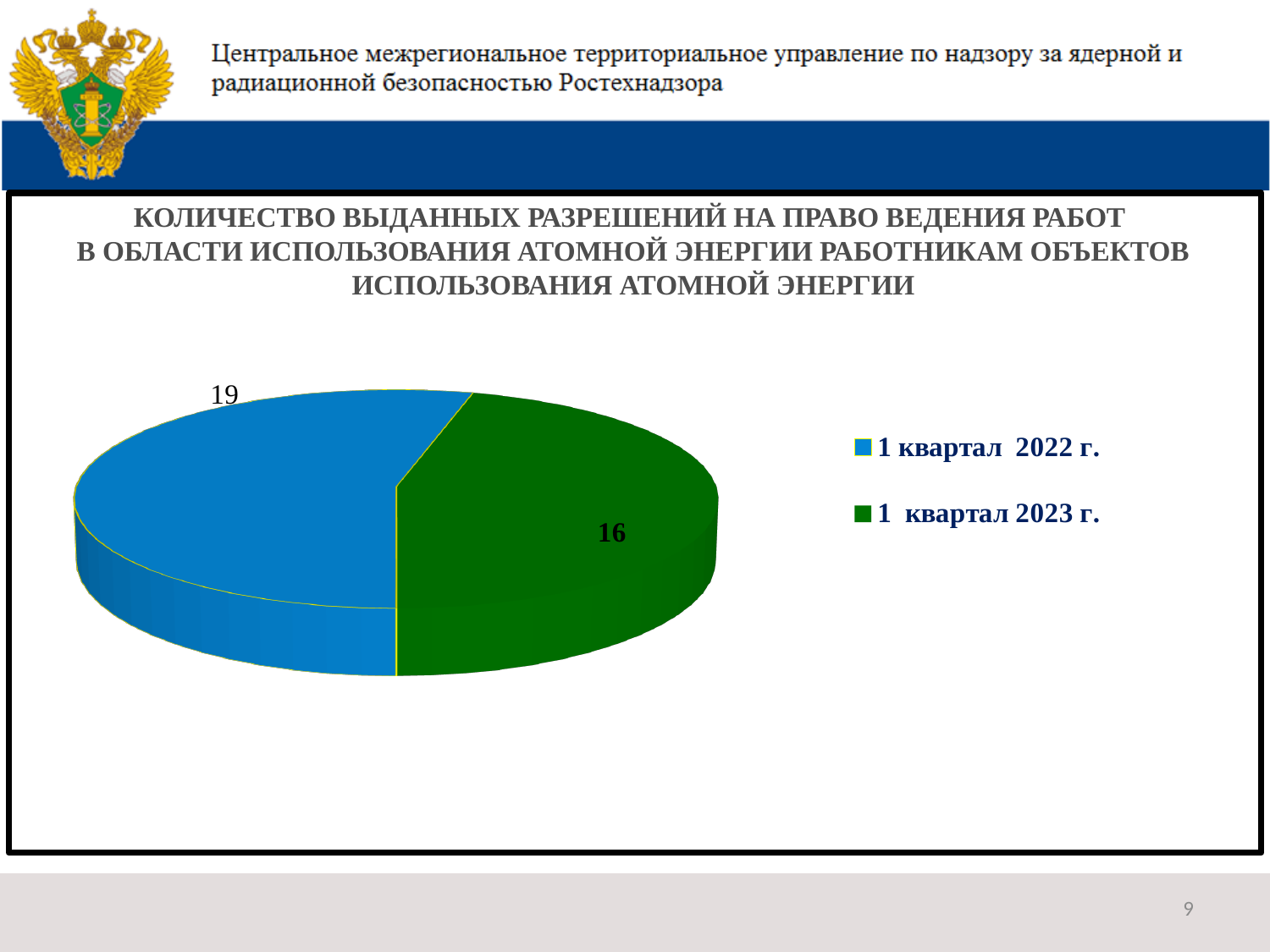
Which category has the smallest slice of the pie? 1 квартал 2023 г. Which category has the largest slice of the pie? 1 квартал 2022 г. How many slices does the pie chart have? 2 What is the value for 1 квартал 2023 г.? 16 What is the value for 1 квартал 2022 г.? 19 What is the total of the two values shown in the pie chart? 35 What type of chart is shown on the slide? pie chart Did the number of permits fall or rise from 1 квартал 2022 г. to 1 квартал 2023 г.? fall How many entries does the legend list? 2 What colour is the slice for 1 квартал 2023 г.? green Which is larger: the value for 1 квартал 2022 г. or for 1 квартал 2023 г.? 1 квартал 2022 г. What is the difference between the values for 1 квартал 2022 г. and 1 квартал 2023 г.? 3